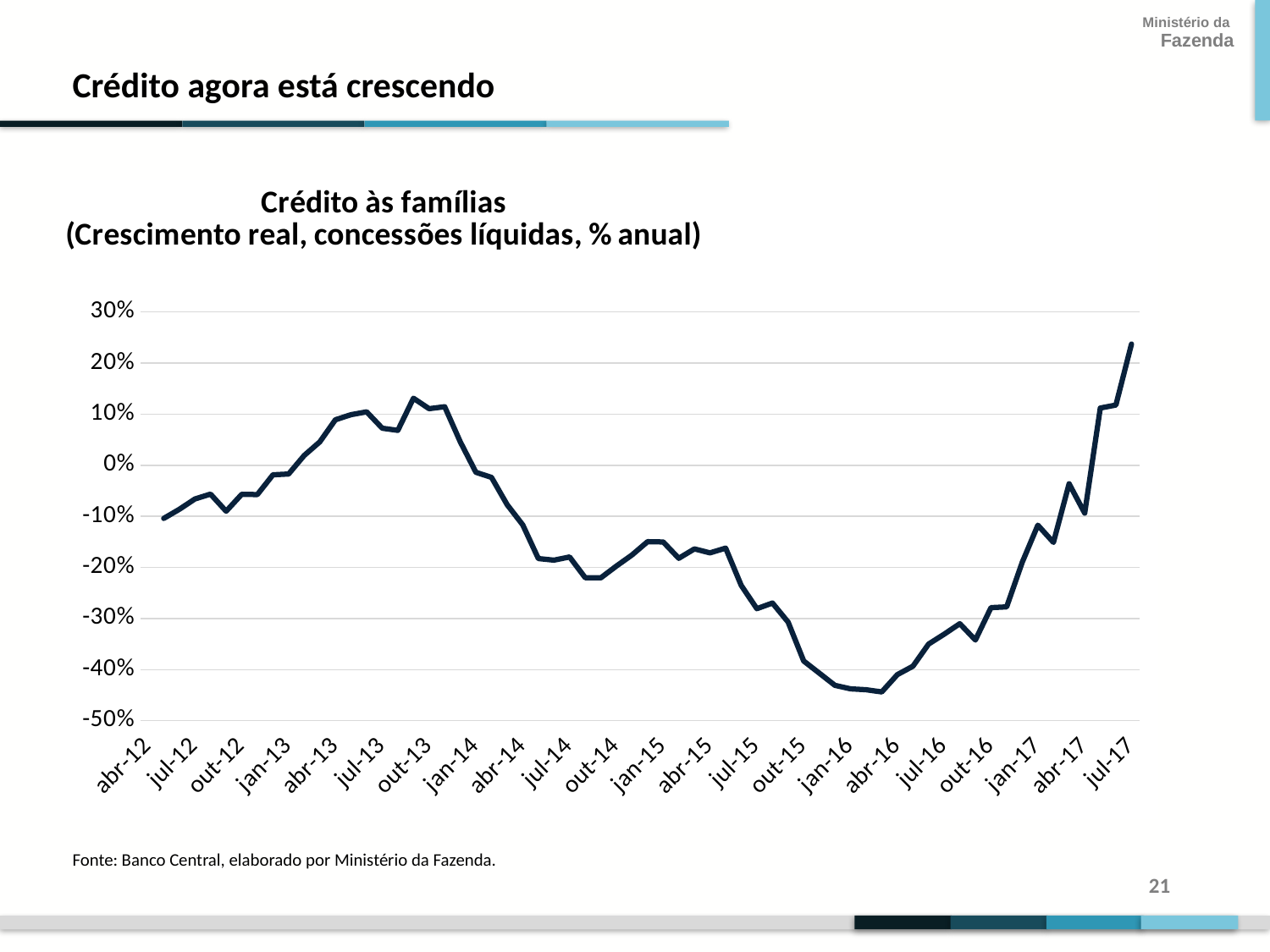
What kind of chart is shown on the slide? line chart Is the value for jul-17 greater or less than 20%? greater What is the title of the chart? Crédito às famílias (Crescimento real, concessões líquidas, % anual) Is the value for abr-15 greater or less than -10%? less How many date labels are shown on the x axis? 22 Is the value for jan-16 greater or less than -40%? less Which labelled date on the x axis has the highest value? jul-17 Which is larger, the value for jan-14 or the value for jan-16? jan-14 In which year does the line reach its lowest point? 2016 Does the line rise or fall between jan-16 and jul-17? rise